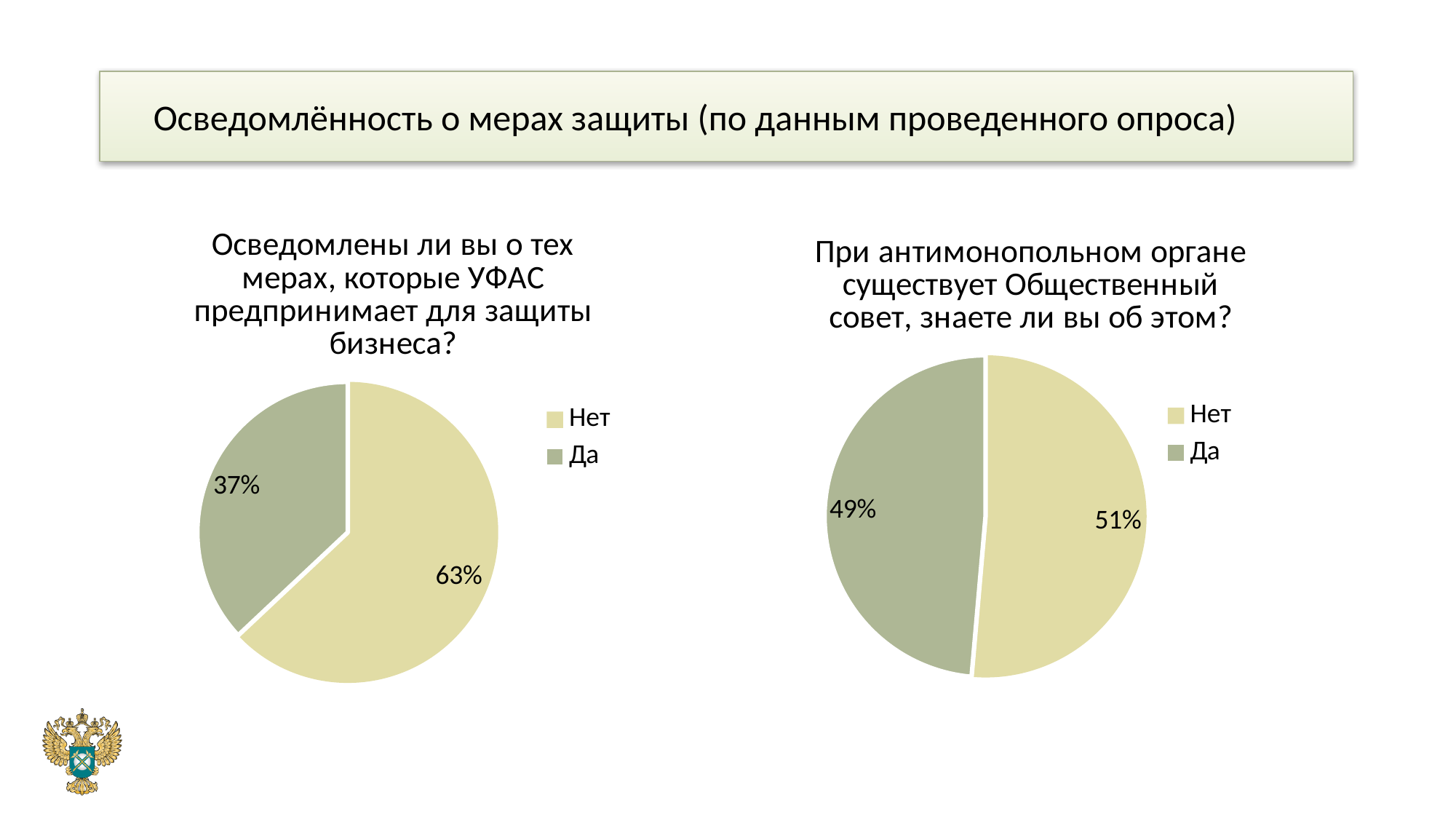
In the right pie chart, which colour represents the "Да" answer? Grey-green In the left pie chart, which answer has the smallest slice? Да In the right pie chart, what is the difference in percentage points between the "Нет" and "Да" slices? 2 percentage points In the right pie chart ("При антимонопольном органе существует Общественный совет, знаете ли вы об этом?"), what share of respondents answered "Да"? 49% In the left pie chart, what is the difference in percentage points between the "Нет" and "Да" slices? 26 percentage points In the left pie chart ("Осведомлены ли вы о тех мерах, которые УФАС предпринимает для защиты бизнеса?"), what share of respondents answered "Да"? 37% How many slices does the right pie chart have? 2 In the left pie chart, which answer has the largest slice? Нет In the left pie chart ("Осведомлены ли вы о тех мерах, которые УФАС предпринимает для защиты бизнеса?"), what share of respondents answered "Нет"? 63% In the right pie chart ("При антимонопольном органе существует Общественный совет, знаете ли вы об этом?"), what share of respondents answered "Нет"? 51% What type of chart is used on the left side of the slide? Pie chart How many entries does the legend of the left pie chart list? 2